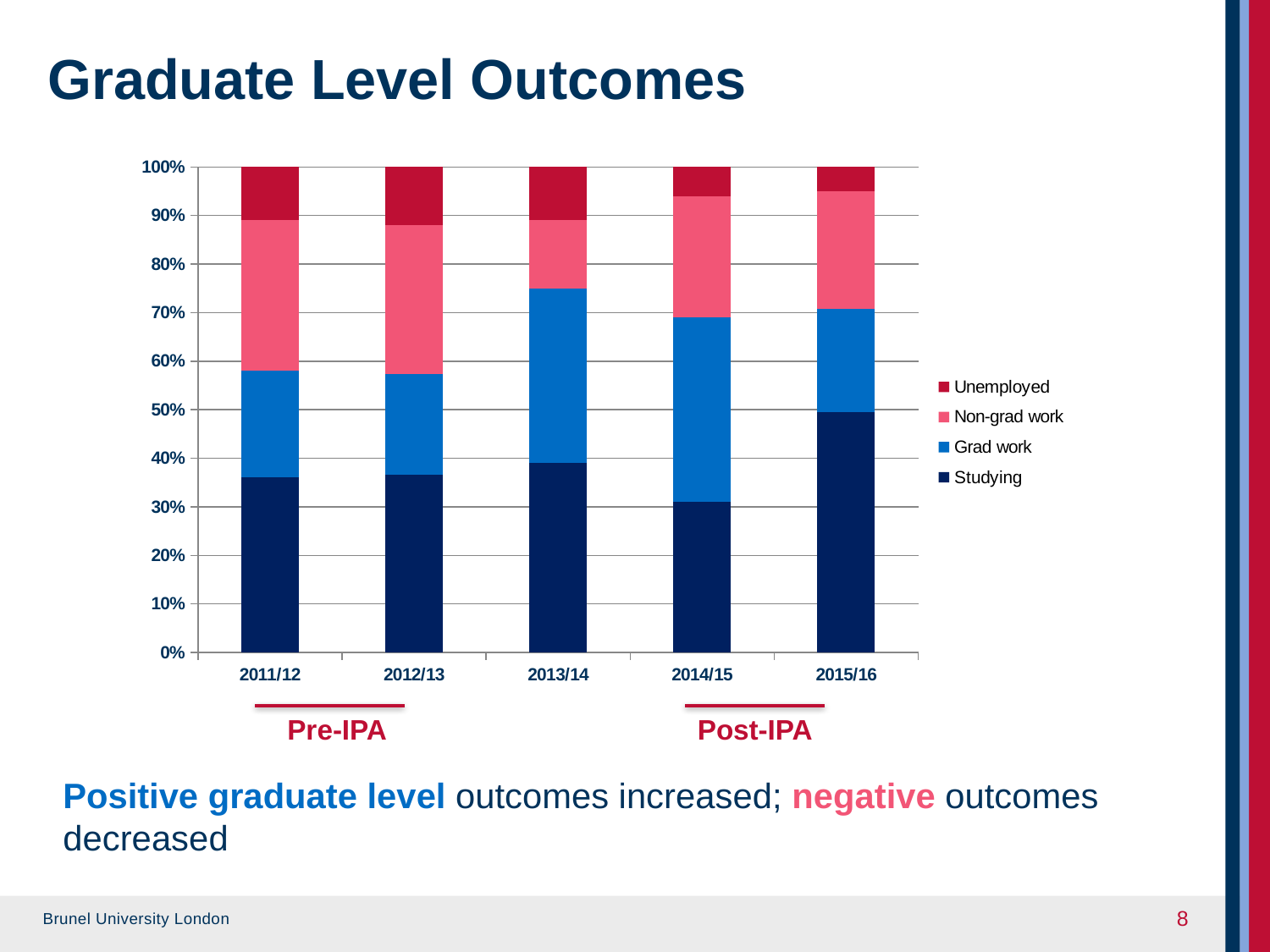
How many series does the chart's legend list? 4 Is the Studying share for 2011/12 greater or less than 40%? less What is the title of the slide containing the chart? Graduate Level Outcomes What kind of chart is shown on the slide? Stacked bar chart In which year is the Studying segment the largest? 2015/16 How many academic years are shown on the x axis of the chart? 5 Is the combined share of Studying and Grad work in 2011/12 greater or less than 70%? less Which year has the larger Unemployed segment, 2012/13 or 2015/16? 2012/13 In which year is the Studying segment the smallest? 2014/15 Which legend entry is shown in dark navy blue? Studying Is the combined share of Studying and Grad work in 2013/14 greater or less than 70%? greater Does the Unemployed share rise or fall from 2011/12 to 2015/16? Fall